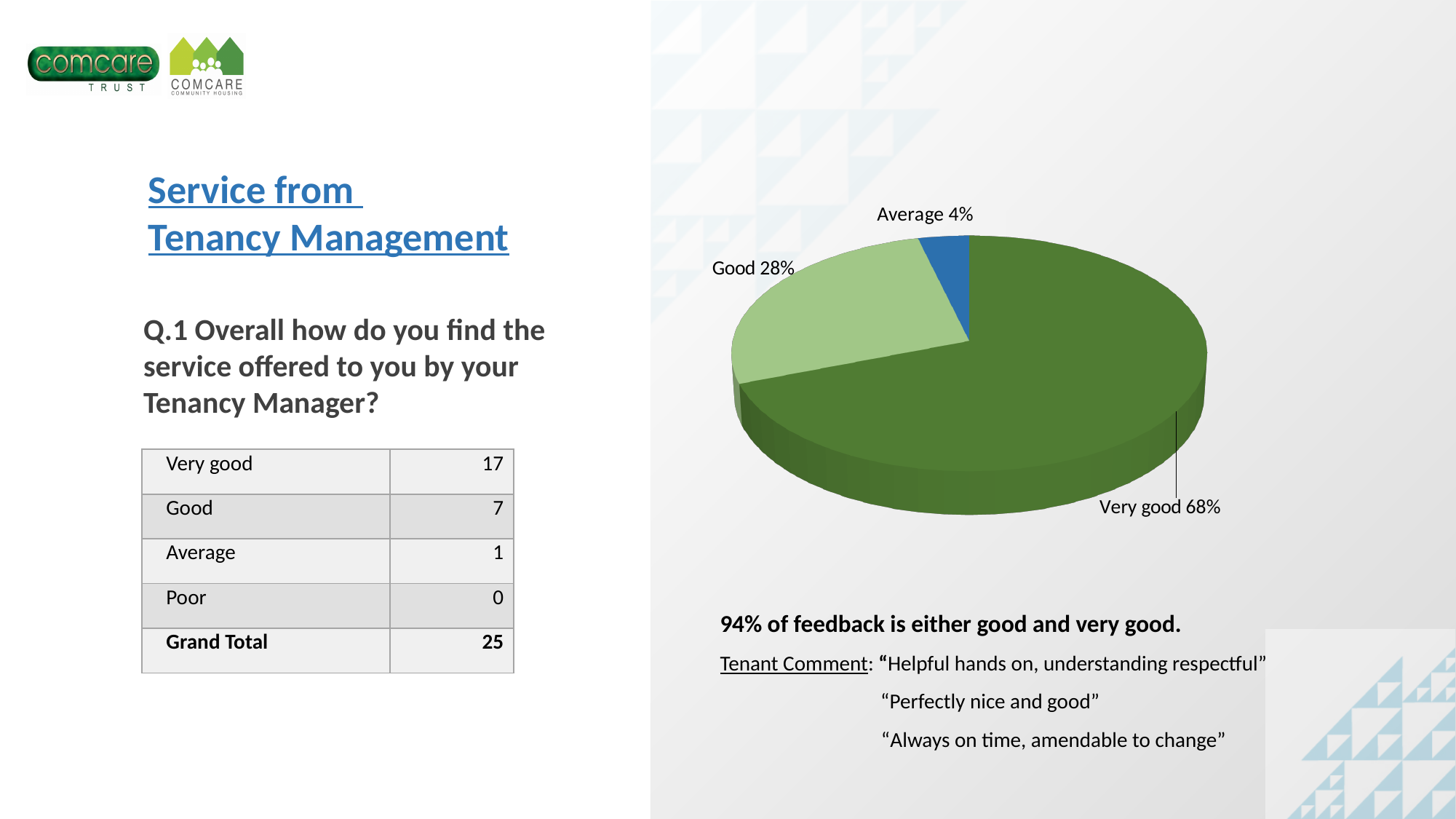
What share of the pie does the Very good slice represent? 68% What colour is the Average slice of the pie chart? blue Which slice is larger, Good or Average? Good What share of the pie does the Good slice represent? 28% Which slice of the pie chart is the largest? Very good Which slice of the pie chart is the smallest? Average What is the combined share of the Good and Very good slices? 96% What share of the pie does the Average slice represent? 4% What kind of chart is shown on the slide? pie chart How many slices are labelled on the pie chart? 3 What is the difference in percentage points between the Very good and Good slices? 40 Which slice of the pie chart is shown in dark green? Very good